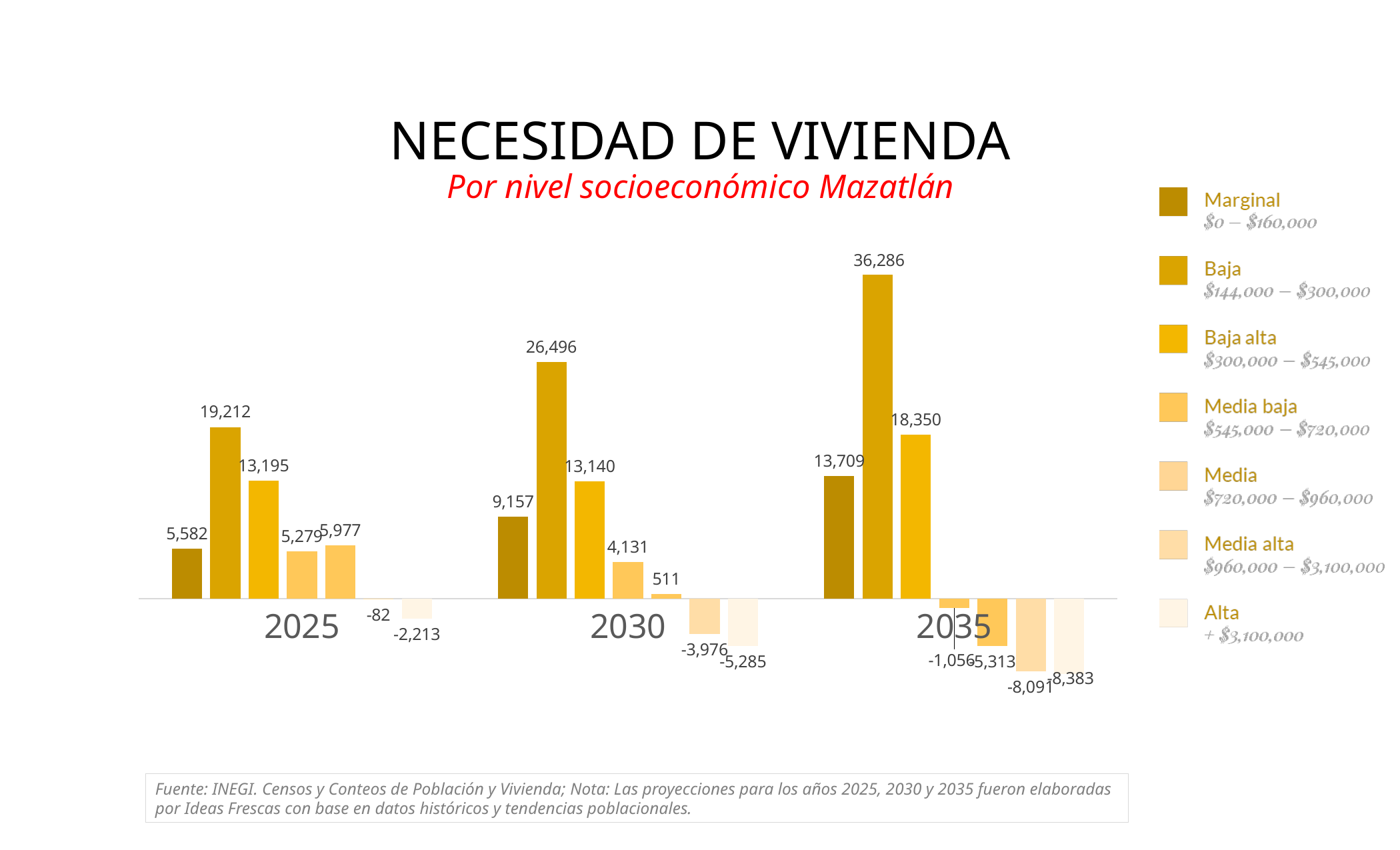
What is the difference between the Marginal values for 2035 and 2025? 8,127 What is the value for Media in 2030? 511 How many years are shown on the x axis? 3 Does the value for Baja rise or fall from 2025 to 2035? rise Which socioeconomic level has the highest value in 2025? Baja How many series does the legend list? 7 Which socioeconomic level has the lowest value in 2030? Alta What is the difference between the Baja values for 2030 and 2025? 7,284 What is the value for Baja in 2035? 36,286 In 2030, which is larger: Media baja or Media? Media baja What is the value for Marginal in 2030? 9,157 What is the value for Alta in 2030? -5,285